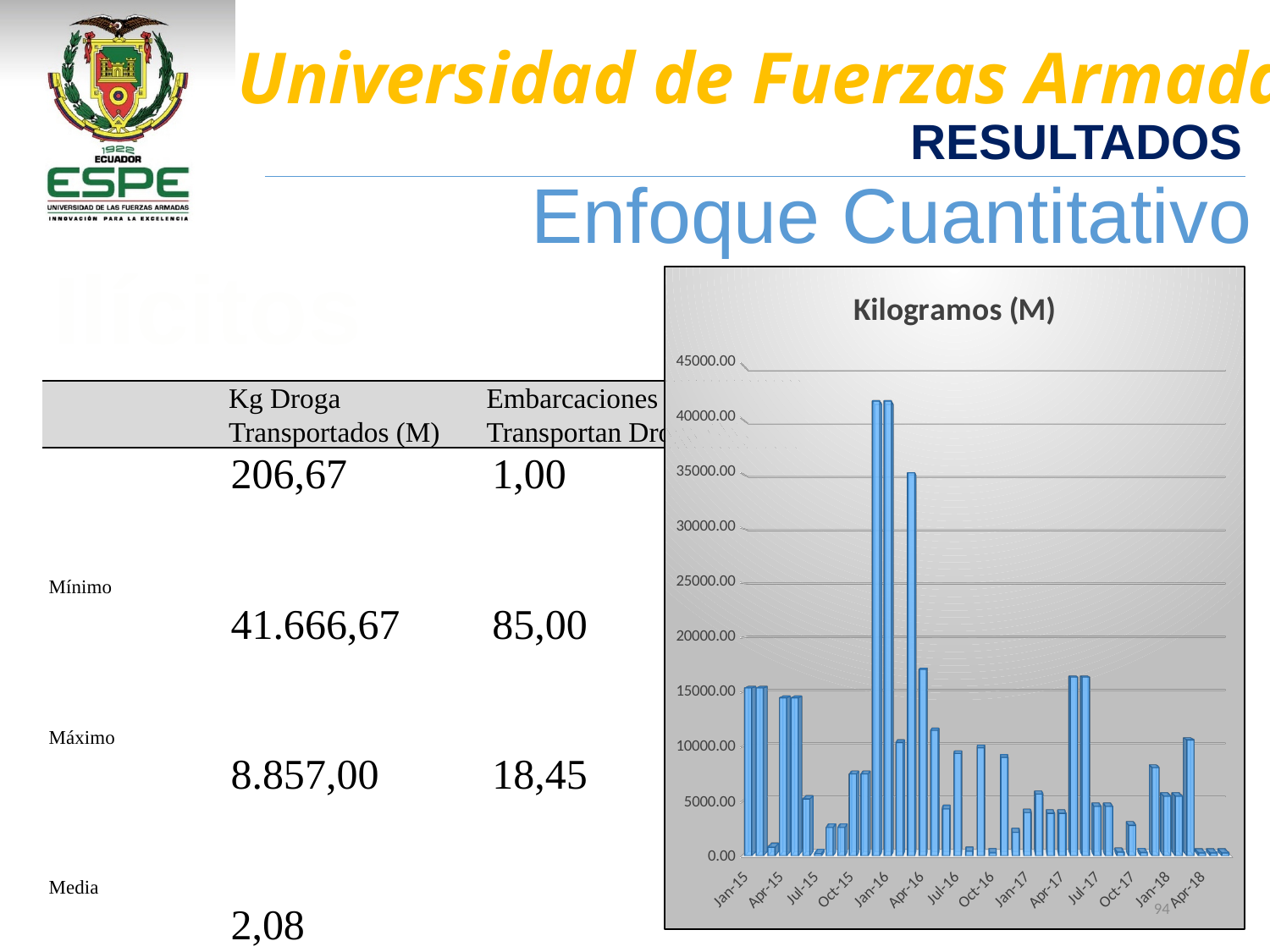
Is the value for Apr-15 greater or less than 5000? greater Is the value for Jan-16 greater or less than 40000? greater What kind of chart is shown on the slide? bar chart Which has the larger value, Jan-15 or Apr-15? Jan-15 Is the value for Apr-16 greater or less than 30000? less Which has the larger value, Jan-16 or Apr-16? Jan-16 How many date labels are shown along the x axis of the chart? 14 What is the highest value shown on the chart's vertical axis? 45000.00 What is the title of the chart on the slide? Kilogramos (M)